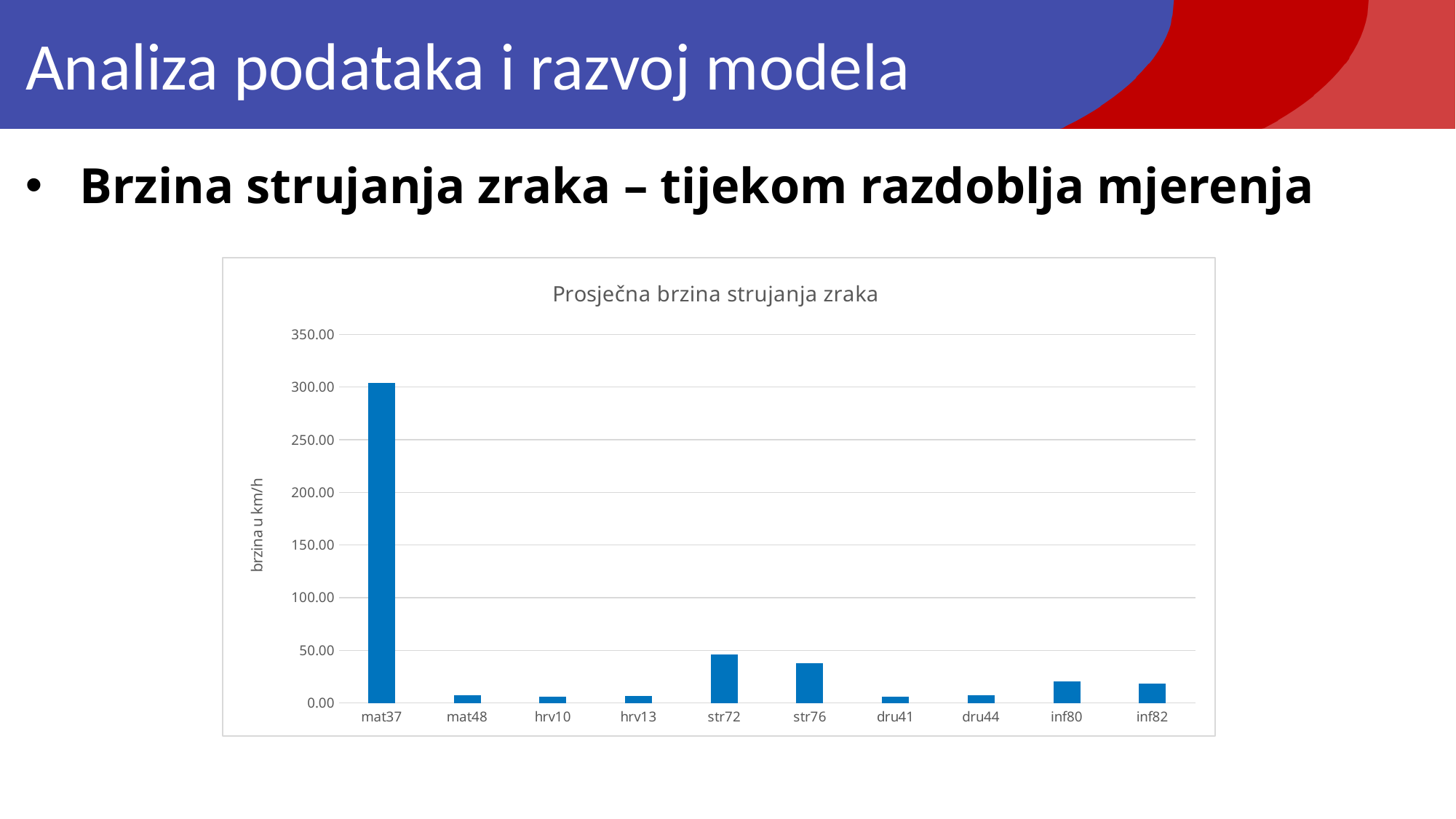
Is the value for str76 greater or less than 50? less Which has the larger value, mat37 or str72? mat37 Is the value for mat37 greater or less than 250? greater What is the title of the chart? Prosječna brzina strujanja zraka Is the value for str72 greater or less than 50? less Which has the larger value, inf80 or hrv10? inf80 How many categories are shown on the x axis of the chart? 10 Which category has the highest value in the chart? mat37 What is the label of the vertical axis of the chart? brzina u km/h Which has the larger value, str72 or str76? str72 What kind of chart is shown on the slide? bar chart